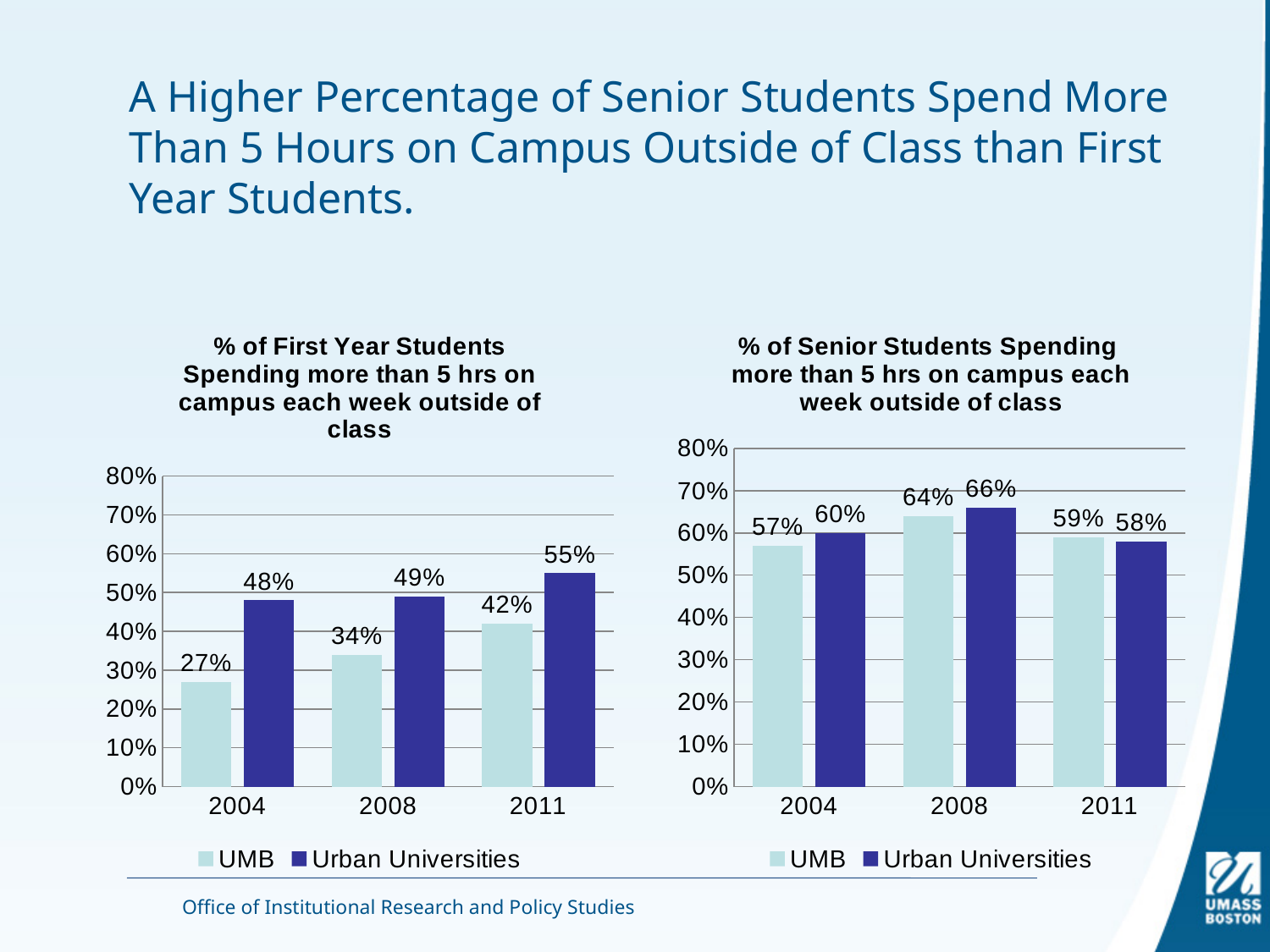
In the right chart (% of Senior Students), which is larger in 2011, UMB or Urban Universities? UMB In the right chart (% of Senior Students), what is the UMB value for 2008? 64% In the left chart (% of First Year Students), what is the UMB value for 2004? 27% In the left chart (% of First Year Students), which year has the lowest UMB value? 2004 In the left chart (% of First Year Students), what is the difference between the Urban Universities and UMB values in 2004? 21% In the right chart (% of Senior Students), which year has the highest Urban Universities value? 2008 In the left chart (% of First Year Students), what is the Urban Universities value for 2011? 55% What kind of chart is the right chart (% of Senior Students)? bar chart How many series does the legend of the left chart (% of First Year Students) list? 2 In the left chart (% of First Year Students), do the UMB values rise or fall from 2004 to 2011? rise In the right chart (% of Senior Students), what is the Urban Universities value for 2011? 58% How many years are shown on the x axis of the right chart (% of Senior Students)? 3